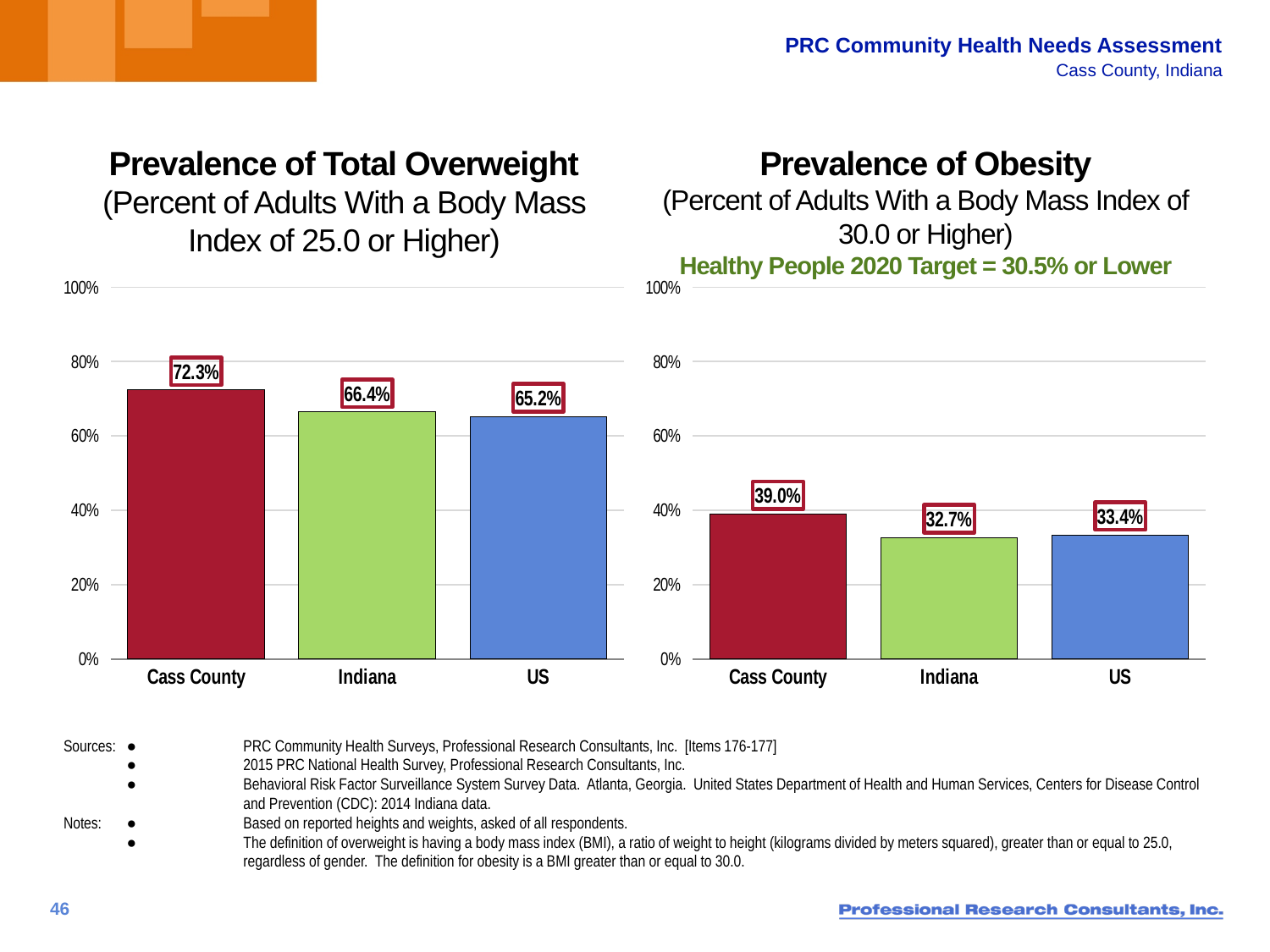
In the Prevalence of Obesity chart, what is the difference between the Cass County and Indiana values? 6.3% In the Prevalence of Total Overweight chart, what is the difference between the Cass County and US values? 7.1% In the Prevalence of Obesity chart, which category has the highest value? Cass County What kind of chart is the Prevalence of Obesity chart? Bar chart How many categories are shown in the Prevalence of Total Overweight chart? 3 In the Prevalence of Total Overweight chart, what is the value for Indiana? 66.4% In the Prevalence of Total Overweight chart, which category has the lowest value? US In the Prevalence of Obesity chart, what is the value for US? 33.4% In the Prevalence of Obesity chart, which is larger, the value for Indiana or the value for US? US In the Prevalence of Total Overweight chart, what is the value for Cass County? 72.3% In the Prevalence of Obesity chart, which category has the lowest value? Indiana What is the Healthy People 2020 Target stated on the Prevalence of Obesity chart? 30.5% or Lower